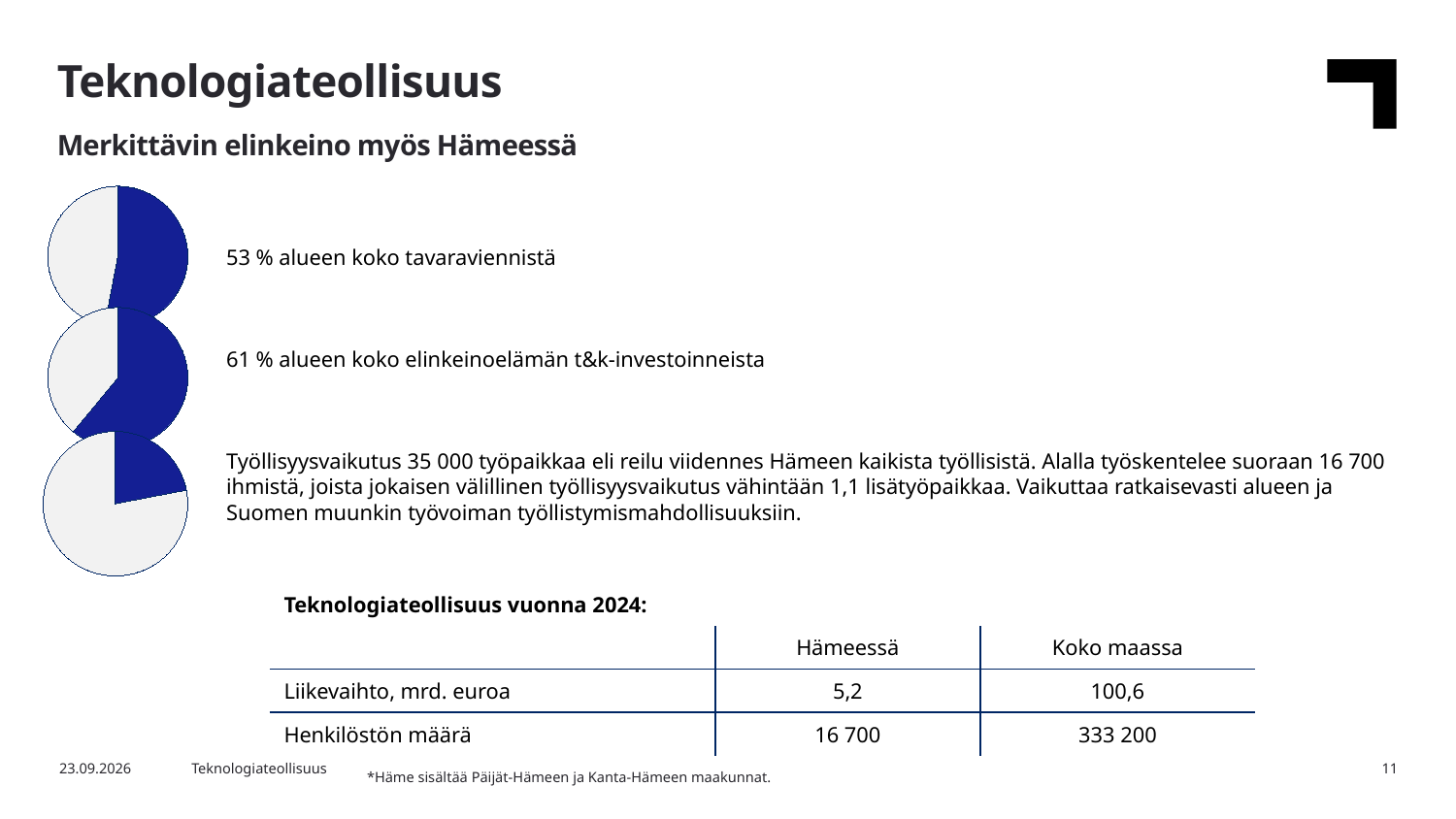
In the middle pie chart, is the blue slice greater or less than 50% of the pie? greater In the bottom pie chart, is the blue slice greater or less than 50% of the pie? less In the top pie chart, what share of the region's total goods exports does the blue slice represent? 53 % Which of the three pie charts has the largest blue slice? The middle pie chart (61 %) In the middle pie chart, what share of the region's business R&D investments does the blue slice represent? 61 % Is the blue slice larger in the top pie chart or in the bottom pie chart? The top pie chart What kind of chart is shown at the top left of the slide? Pie chart What is the difference in percentage points between the blue shares of the middle and top pie charts? 8 percentage points How many slices does each pie chart have? 2 How many pie charts are on the slide? 3 Which of the three pie charts has the smallest blue slice? The bottom pie chart What colour is the highlighted slice in the pie charts? Dark blue